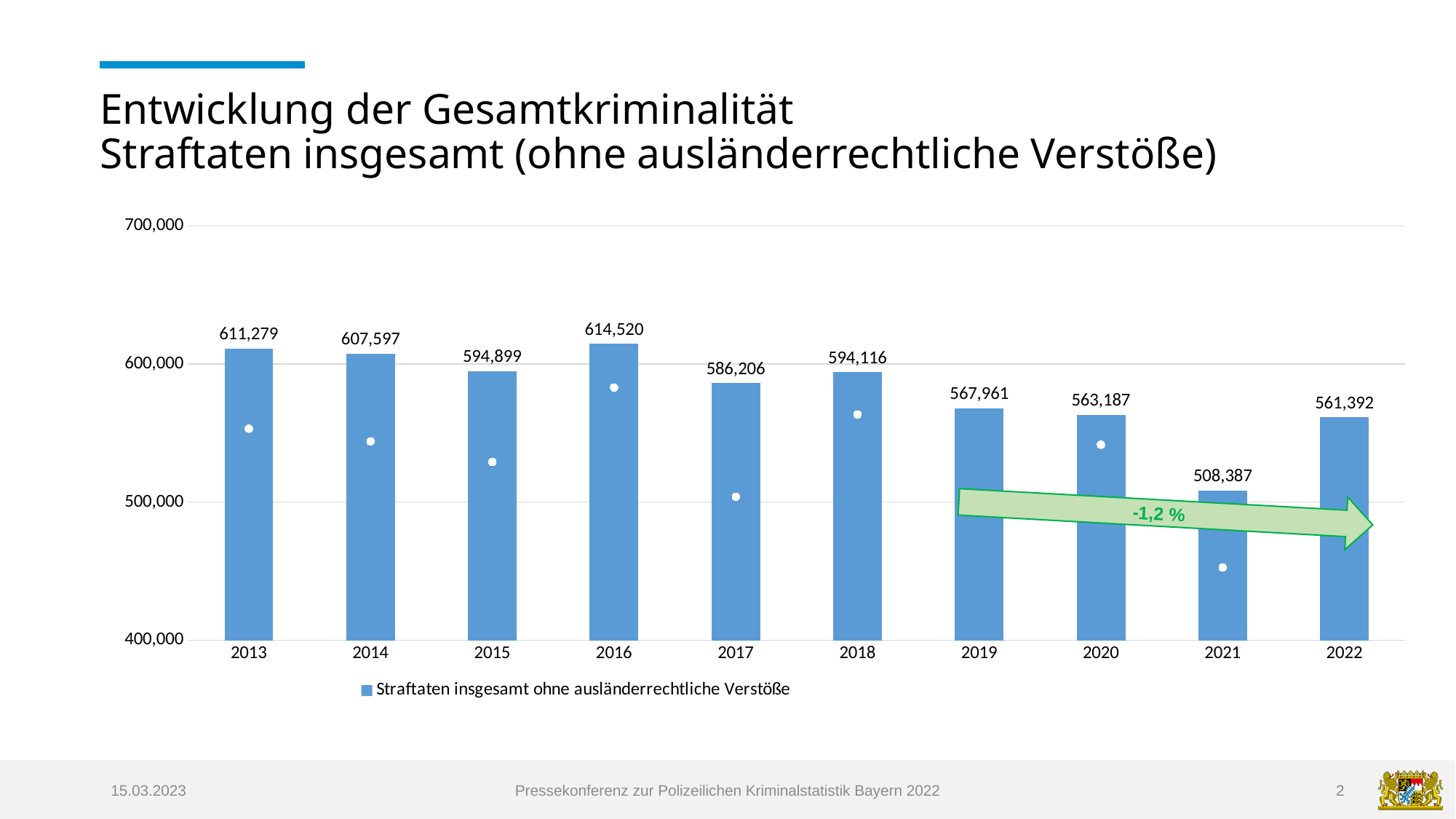
Which year has the lowest value? 2021 What is the difference between the values for 2013 and 2014? 3,682 What is the value for 2022? 561,392 Which year has the highest value? 2016 Which is larger, the value for 2019 or the value for 2020? 2019 Is the value for 2021 greater or less than 600,000? less What is the difference between the values for 2022 and 2021? 53,005 What is the value for 2021? 508,387 How many years are shown on the x axis? 10 What kind of chart is shown on the slide? bar chart What percentage change is written on the green arrow? -1,2 % What is the value for 2016? 614,520